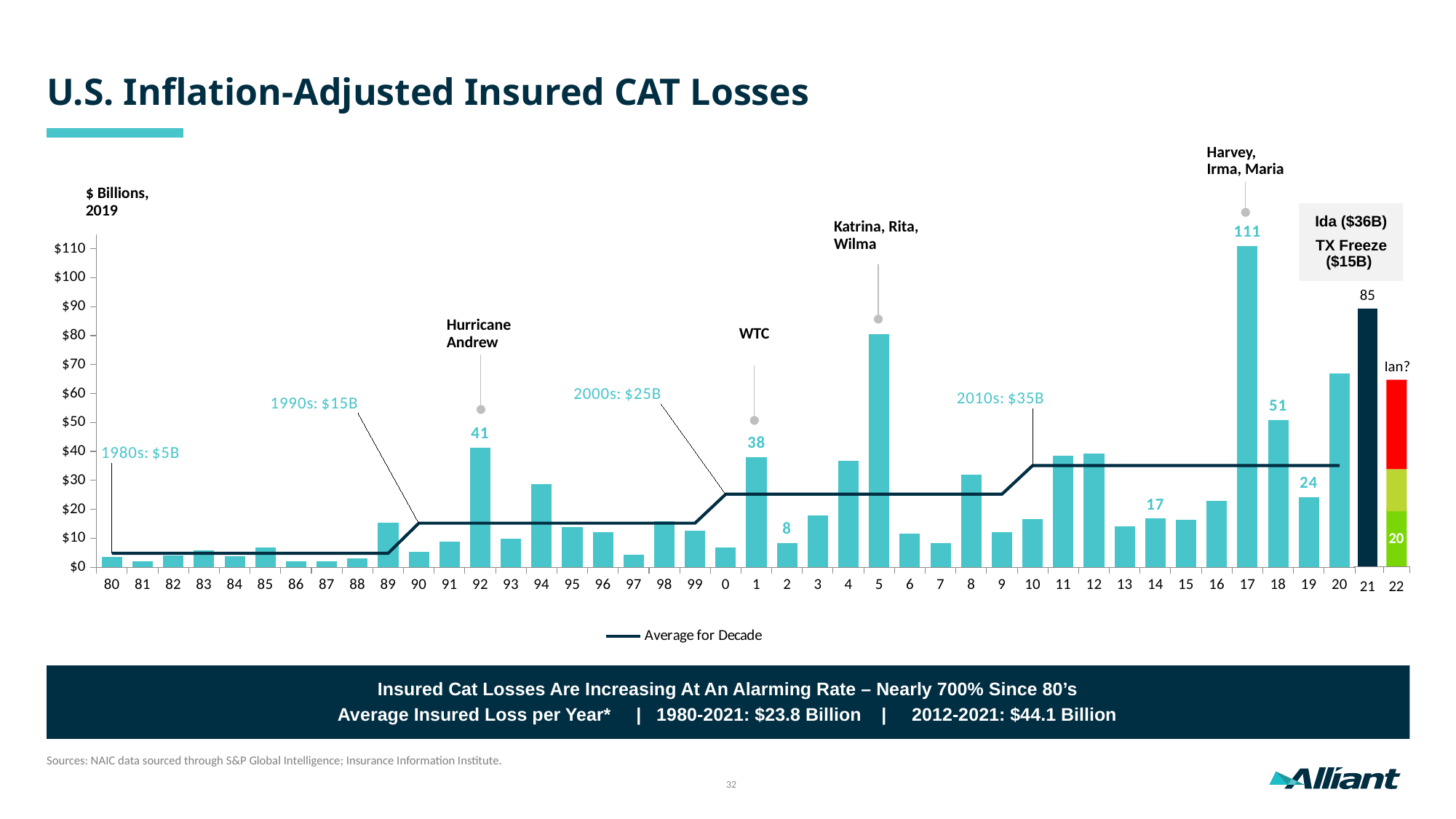
Which year has the highest insured CAT loss bar? 2017 (17) Is the value for 1994 (year 94) greater or less than $40? less What value is labeled on the bar for 1992 (Hurricane Andrew)? 41 What kind of chart is shown on the slide? combination bar and line chart Which year has the larger labeled value, 2018 or 2019? 2018 What does the legend label the dark line on the chart? Average for Decade What is the average for the 2010s decade shown on the chart? $35B What is the insured CAT loss value labeled for 2017 (year 17)? 111 What value is labeled on the bar for 2021 (year 21)? 85 What value is labeled on the bar for 2001 (WTC)? 38 Is the value for 2005 (year 5) greater or less than $70? greater What is the difference between the labeled values for 2017 and 2018? 60